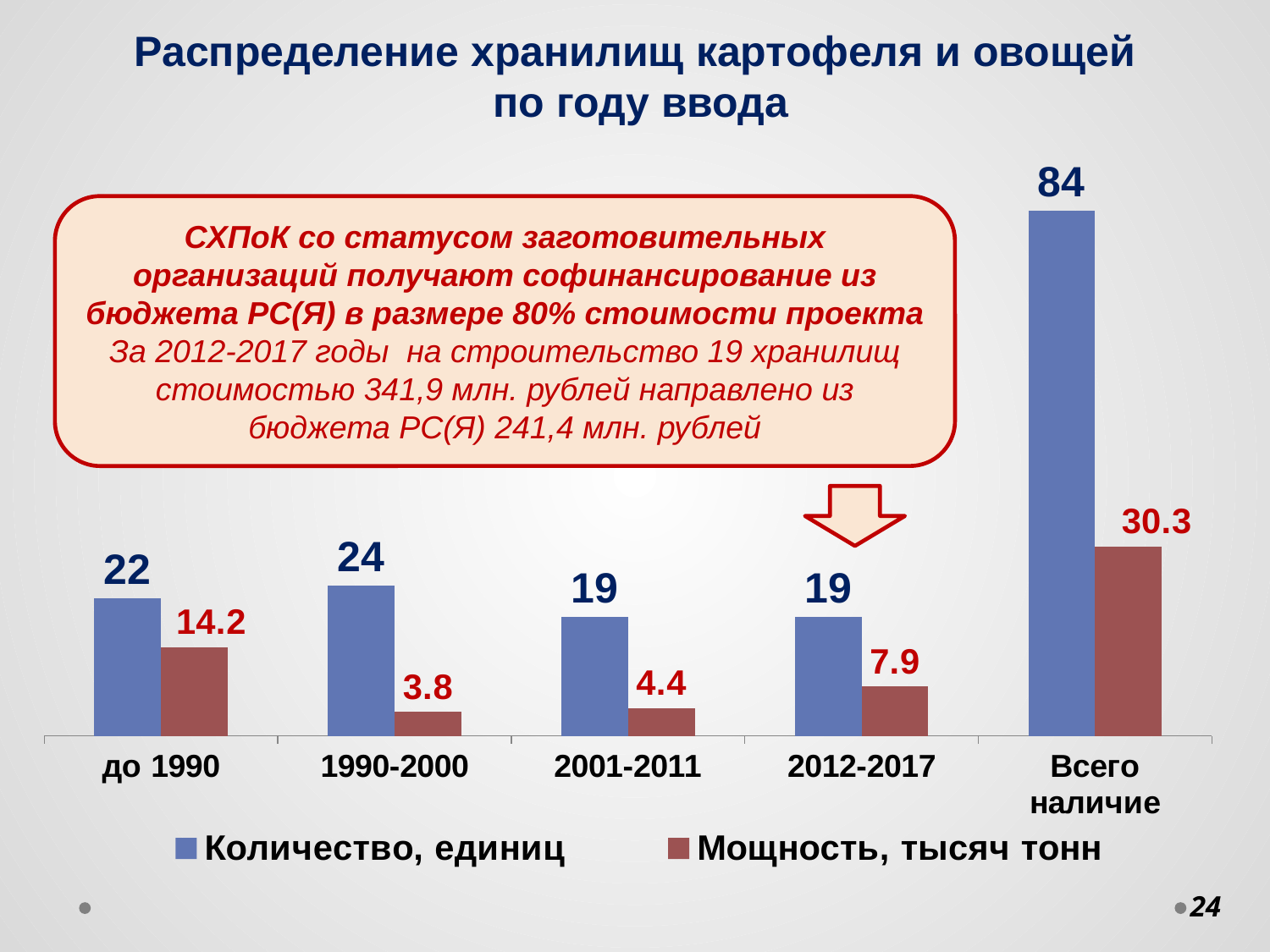
What is the value of "Количество, единиц" for "Всего наличие"? 84 What is the difference between the "Мощность, тысяч тонн" values for "до 1990" and "2012-2017"? 6.3 How many categories are shown on the x axis of the chart? 5 What is the value of "Количество, единиц" for the category "1990-2000"? 24 Among the period categories (excluding "Всего наличие"), which has the lowest value of "Мощность, тысяч тонн"? 1990-2000 What is the value of "Мощность, тысяч тонн" for the category "2012-2017"? 7.9 What type of chart is shown on the slide? Bar chart What is the value of "Мощность, тысяч тонн" for the category "до 1990"? 14.2 How many series does the chart legend list? 2 Among the period categories (excluding "Всего наличие"), which has the highest value of "Количество, единиц"? 1990-2000 Which is larger: the "Мощность, тысяч тонн" value for "2001-2011" or for "1990-2000"? 2001-2011 Which series is shown in blue in the chart? Количество, единиц